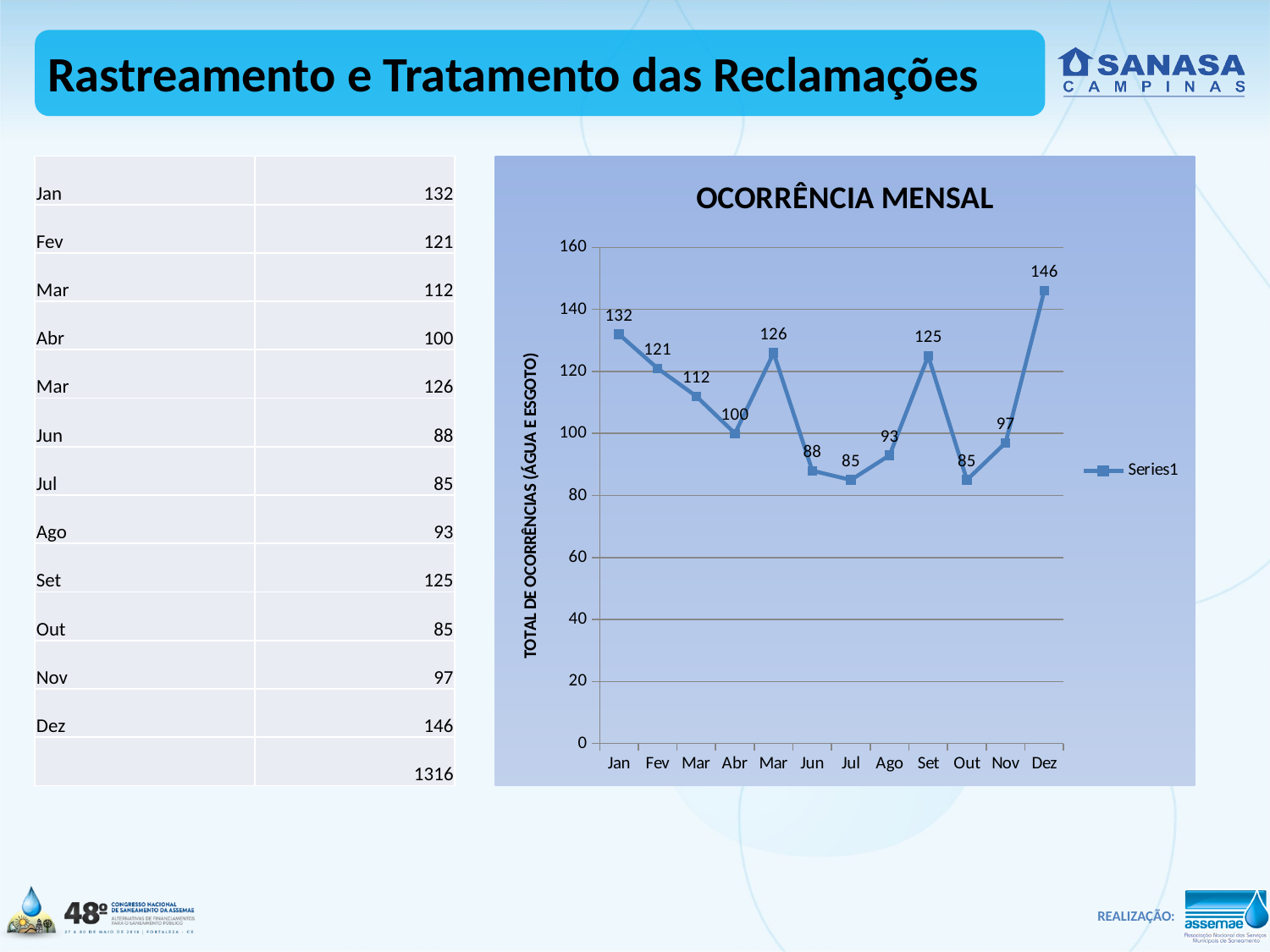
What type of chart is shown on the slide? line chart How many data points are plotted in the chart? 12 Do the values rise or fall from Jan to Abr? fall Which has a larger value, Fev or Ago? Fev What is the value for Set in the chart? 125 What is the title of the chart? OCORRÊNCIA MENSAL What is the lowest value plotted in the chart? 85 What is the difference between the values for Dez and Nov? 49 Which month has the highest value in the chart? Dez What is the value for Jan in the chart? 132 How many series does the legend list? 1 What is the value for Jun in the chart? 88